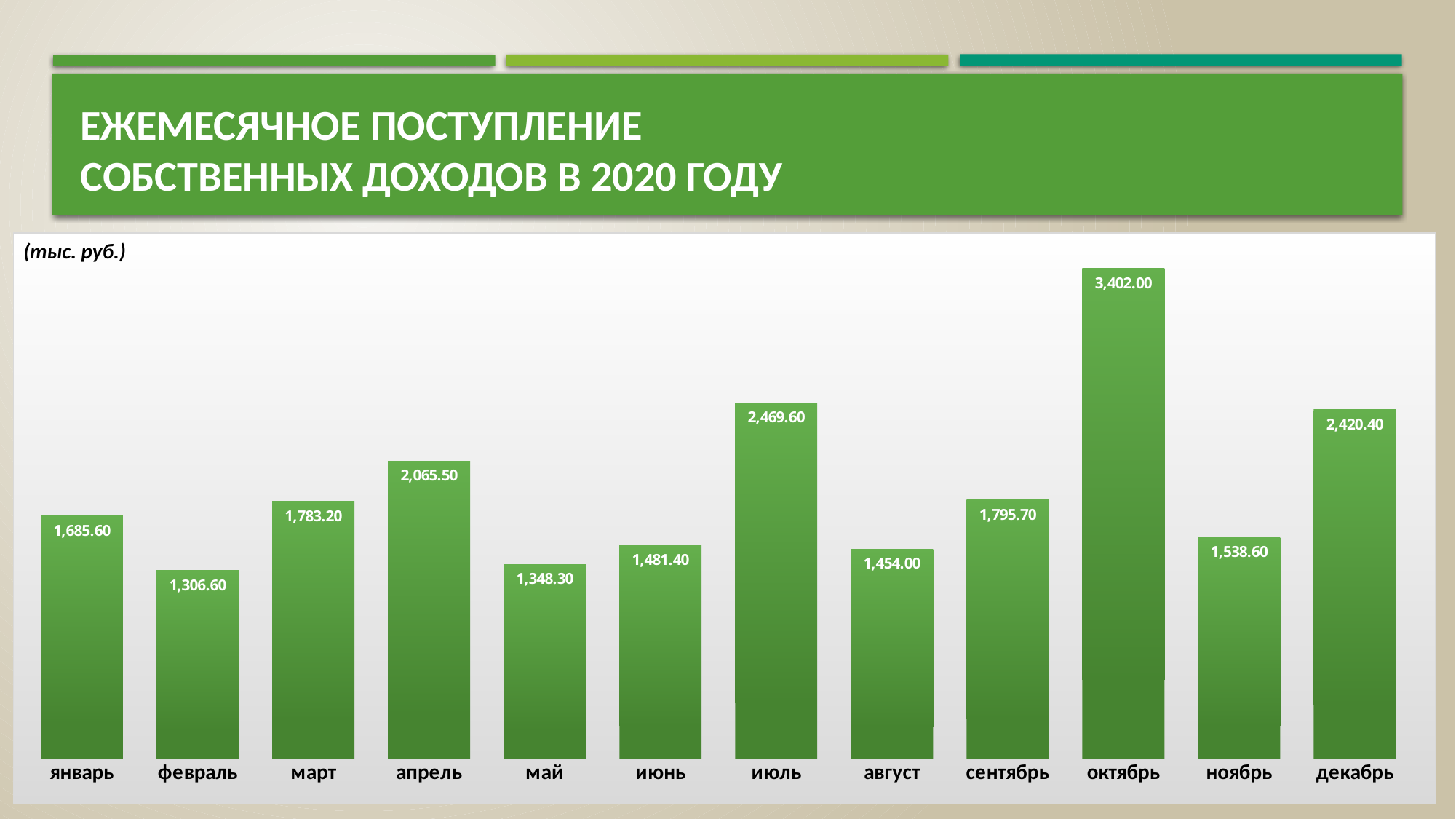
What is the value for июль? 2,469.60 Which is larger, the value for декабрь or the value for апрель? декабрь Which month has the highest value? октябрь What is the difference between the values for октябрь and июль? 932.40 What is the value for сентябрь? 1,795.70 What is the value for октябрь? 3,402.00 What is the value for февраль? 1,306.60 What kind of chart is shown on the slide? bar chart What unit is indicated in the top-left corner of the chart? (тыс. руб.) Which month has the lowest value? февраль What is the difference between the values for апрель and март? 282.30 How many months are shown on the chart? 12